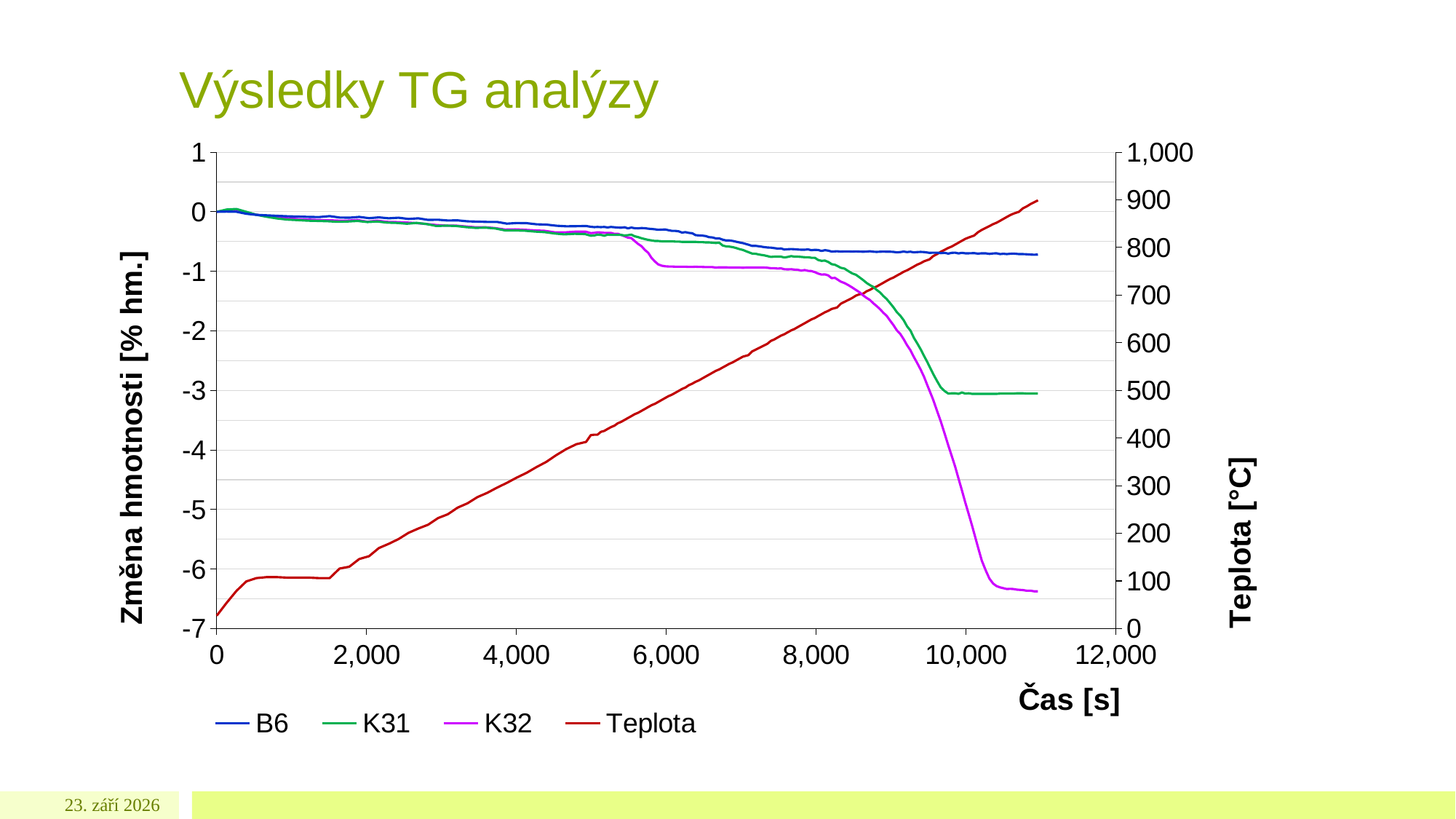
What kind of chart is shown on the slide? line chart What are the series names listed in the legend? B6, K31, K32, Teplota At the end of the measurement (around 11,000 s), which has the larger mass change value, K31 or K32? K31 Is the final value of K31 (around 11,000 s) greater or less than -4? greater Is the Teplota value at 8,000 s greater or less than 600? greater How many series does the legend list? 4 Does the Teplota series rise or fall along the x axis? rise Which series ends at the lowest mass change value at the end of the measurement? K32 Is the Teplota value at 4,000 s greater or less than 300? greater What is the title of the x axis? Čas [s]